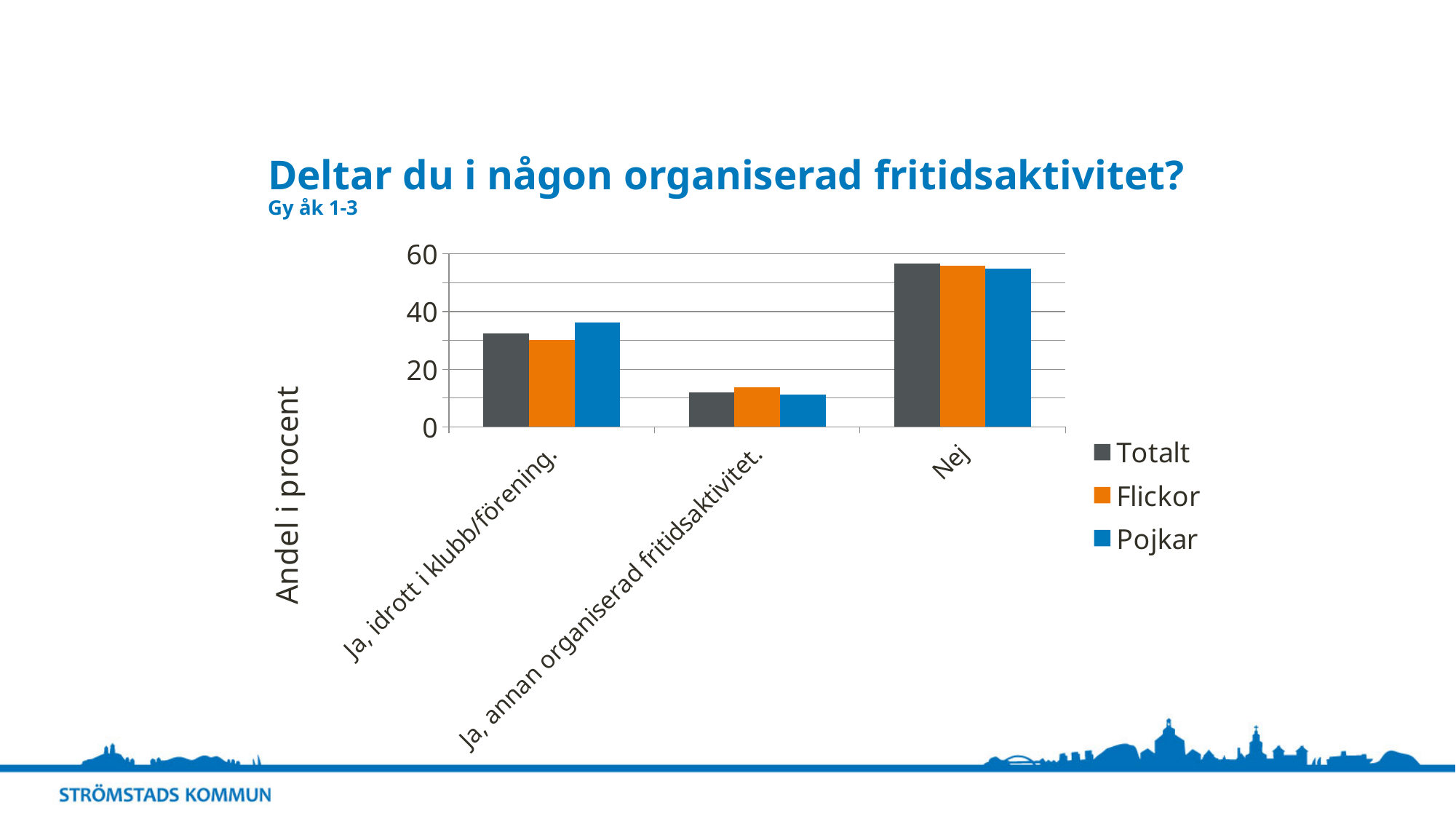
How many series does the chart's legend list? 3 What kind of chart is shown on the slide? bar chart What is the title of the chart on the slide? Deltar du i någon organiserad fritidsaktivitet? In the category "Ja, idrott i klubb/förening.", which series has the larger value, Flickor or Pojkar? Pojkar Is the value for Pojkar in the category "Nej" greater or less than 40? greater Is the value for Flickor in the category "Ja, annan organiserad fritidsaktivitet." greater or less than 20? less Is the value for Totalt in the category "Ja, idrott i klubb/förening." greater or less than 20? greater Which category has the lowest value for the Pojkar series? Ja, annan organiserad fritidsaktivitet. What is the label of the vertical axis of the chart? Andel i procent How many categories are shown on the x axis of the chart? 3 Which category has the highest value for the Totalt series? Nej For the Totalt series, which category has the larger value, "Ja, idrott i klubb/förening." or "Ja, annan organiserad fritidsaktivitet."? Ja, idrott i klubb/förening.